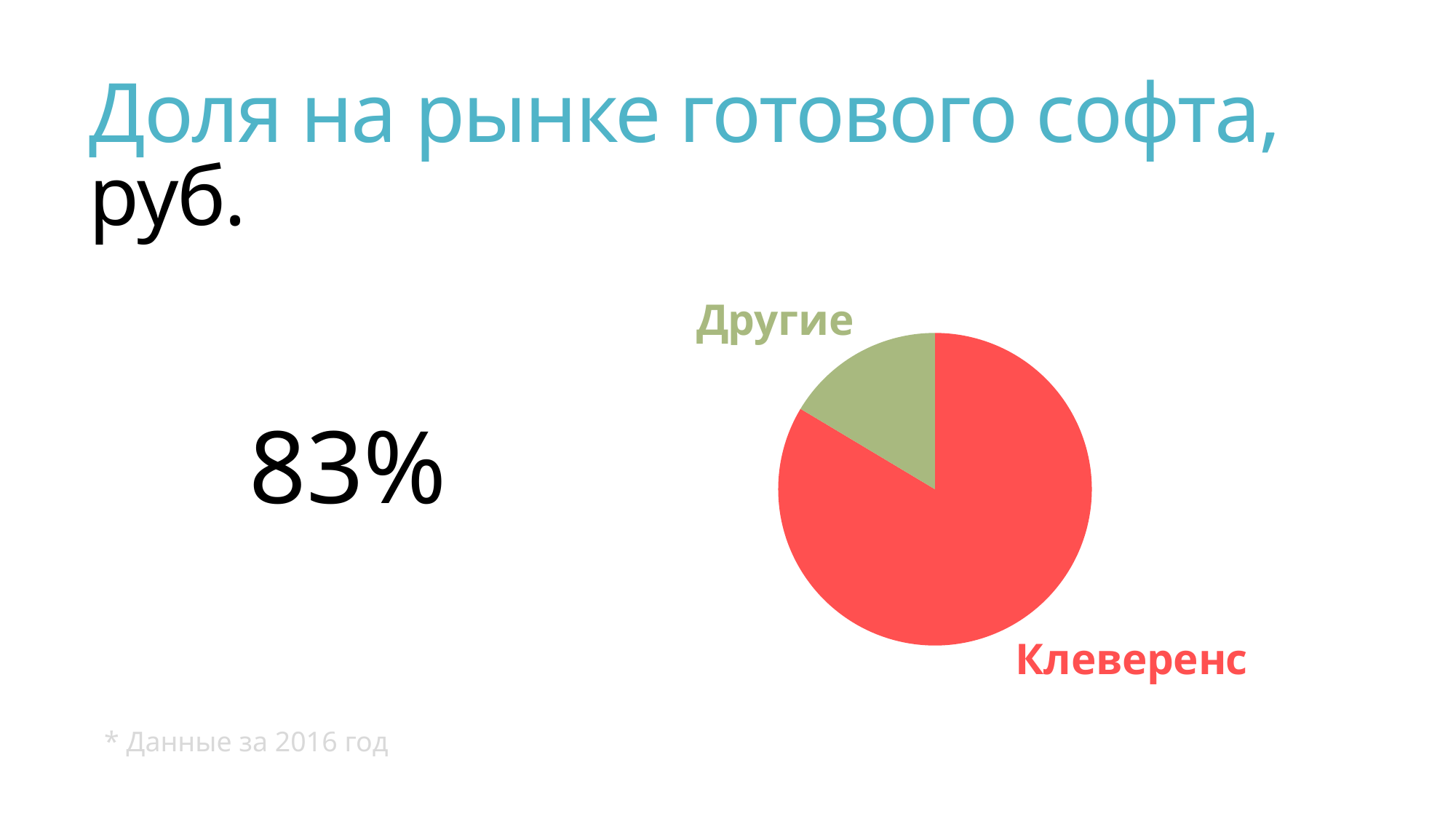
Which slice of the pie chart is the smallest? Другие What is the title of the slide containing the pie chart? Доля на рынке готового софта, руб. Which slice of the pie chart is the largest? Клеверенс What colour is the Клеверенс slice of the pie chart? red What share of the market does Клеверенс hold according to the slide? 83% How many slices does the pie chart have? 2 Which is larger in the pie chart, Клеверенс or Другие? Клеверенс What kind of chart is shown on the slide? pie chart